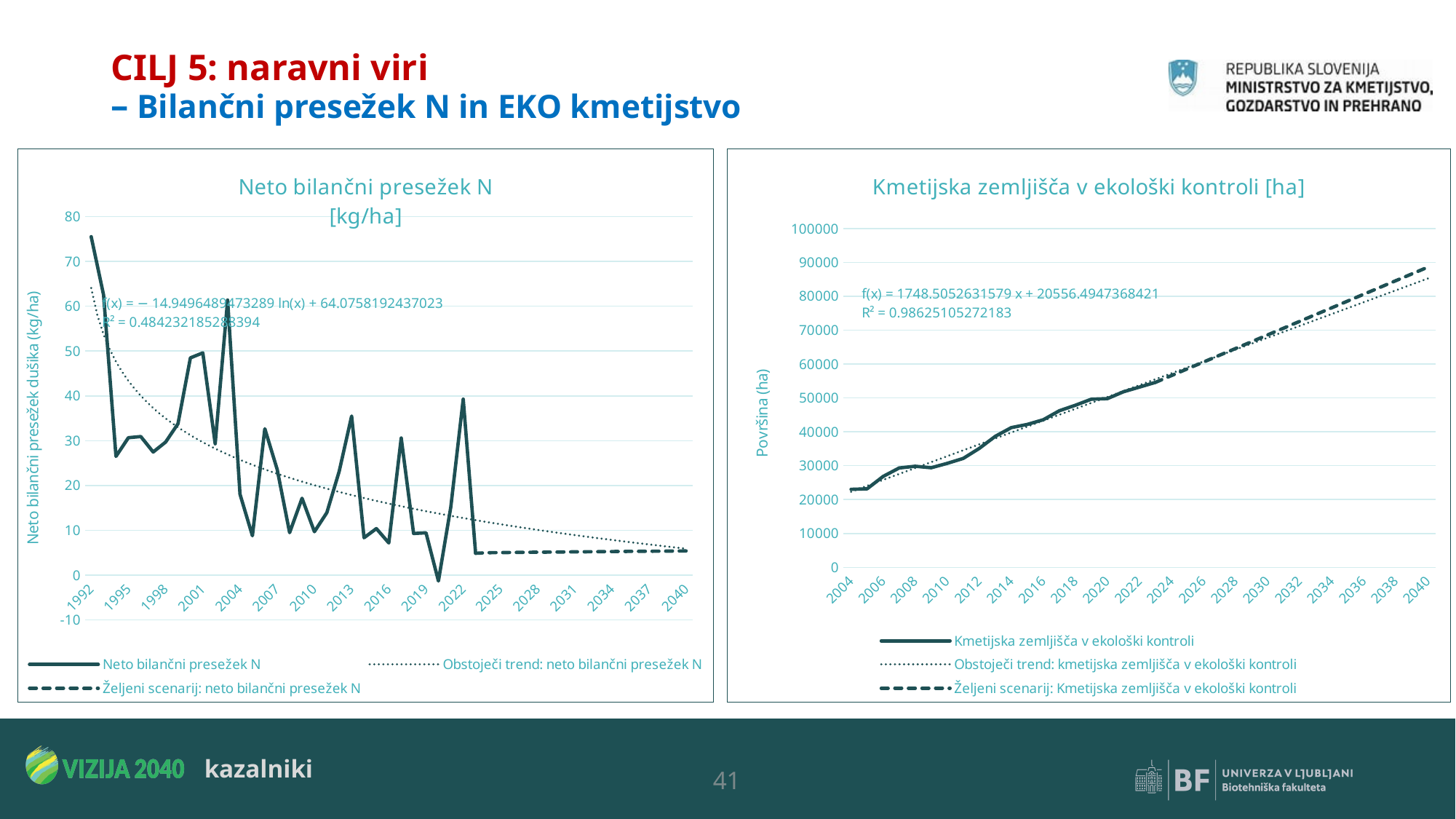
What kind of chart is the left chart titled "Neto bilančni presežek N [kg/ha]"? line chart What is the y-axis label of the right chart "Kmetijska zemljišča v ekološki kontroli [ha]"? Površina (ha) In the left chart "Neto bilančni presežek N [kg/ha]", do the values of the solid line generally rise or fall from 1992 onwards? fall In the right chart "Kmetijska zemljišča v ekološki kontroli [ha]", do the values of the solid line rise or fall from 2004 onwards? rise In the right chart "Kmetijska zemljišča v ekološki kontroli [ha]", is the value for 2004 greater or less than 30000? less In the left chart "Neto bilančni presežek N [kg/ha]", which year has the highest value of the solid line? 1992 What kind of chart is the right chart titled "Kmetijska zemljišča v ekološki kontroli [ha]"? line chart In the left chart "Neto bilančni presežek N [kg/ha]", is the value of the desired scenario (Željeni scenarij) line in 2040 greater or less than 10? less In the left chart "Neto bilančni presežek N [kg/ha]", is the value for 1992 greater or less than 70? greater How many series does the legend of the right chart "Kmetijska zemljišča v ekološki kontroli [ha]" list? 3 How many series does the legend of the left chart "Neto bilančni presežek N [kg/ha]" list? 3